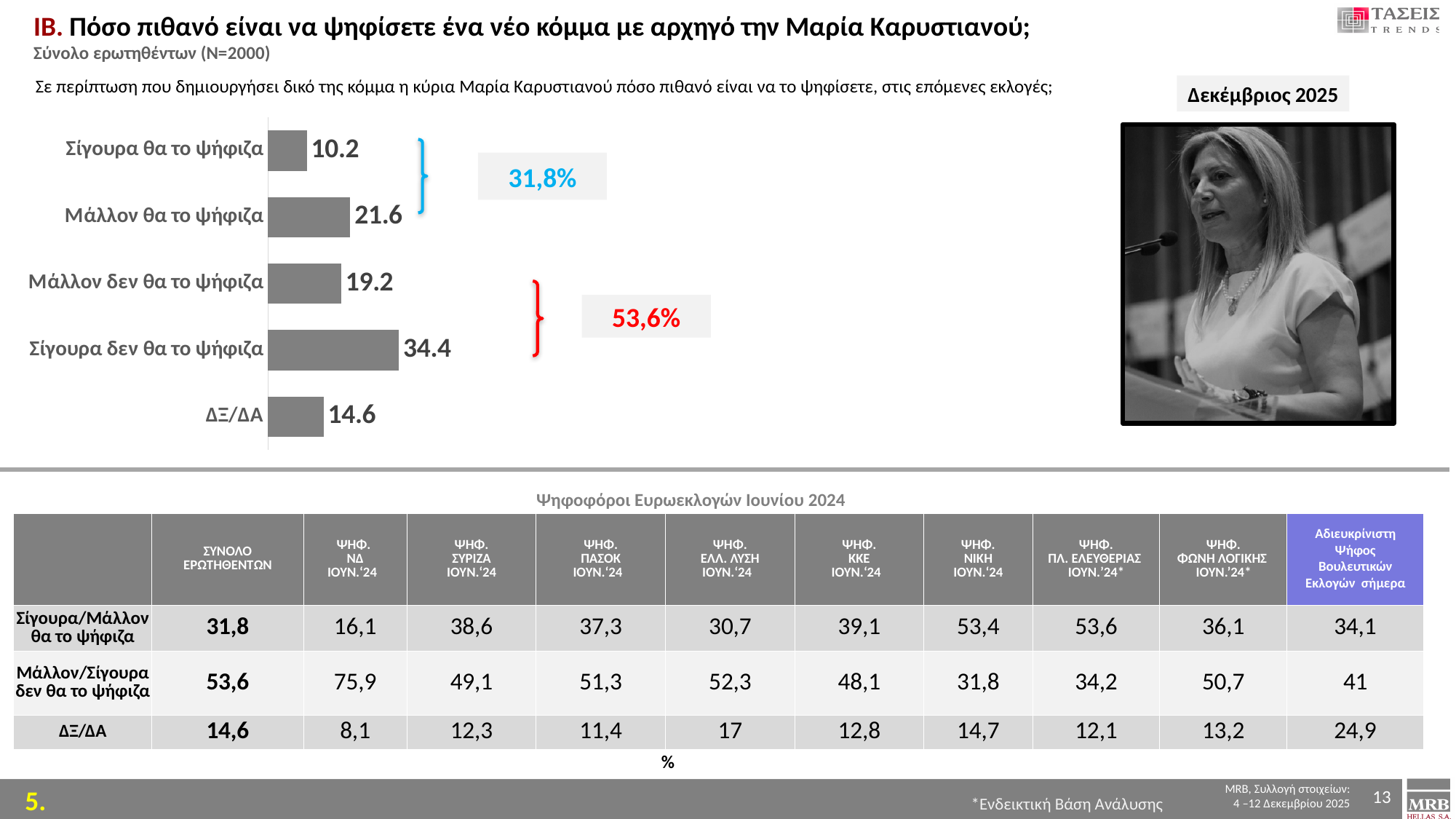
What combined percentage is shown in blue next to the bracket grouping the first two bars? 31,8% Which category has the lowest value in the bar chart? Σίγουρα θα το ψήφιζα How many categories are shown in the bar chart? 5 What value is shown for "Σίγουρα δεν θα το ψήφιζα" in the bar chart? 34.4 What combined percentage is shown in red next to the bracket grouping the "δεν θα το ψήφιζα" bars? 53,6% What value is shown for "Μάλλον θα το ψήφιζα" in the bar chart? 21.6 Which category has the highest value in the bar chart? Σίγουρα δεν θα το ψήφιζα What value is shown for "Σίγουρα θα το ψήφιζα" in the bar chart? 10.2 What is the difference between the values for "Σίγουρα δεν θα το ψήφιζα" and "Μάλλον δεν θα το ψήφιζα" in the bar chart? 15.2 What kind of chart is shown on the slide? Bar chart Which is larger in the bar chart: the value for "Μάλλον θα το ψήφιζα" or for "Μάλλον δεν θα το ψήφιζα"? Μάλλον θα το ψήφιζα What value is shown for "ΔΞ/ΔΑ" in the bar chart? 14.6